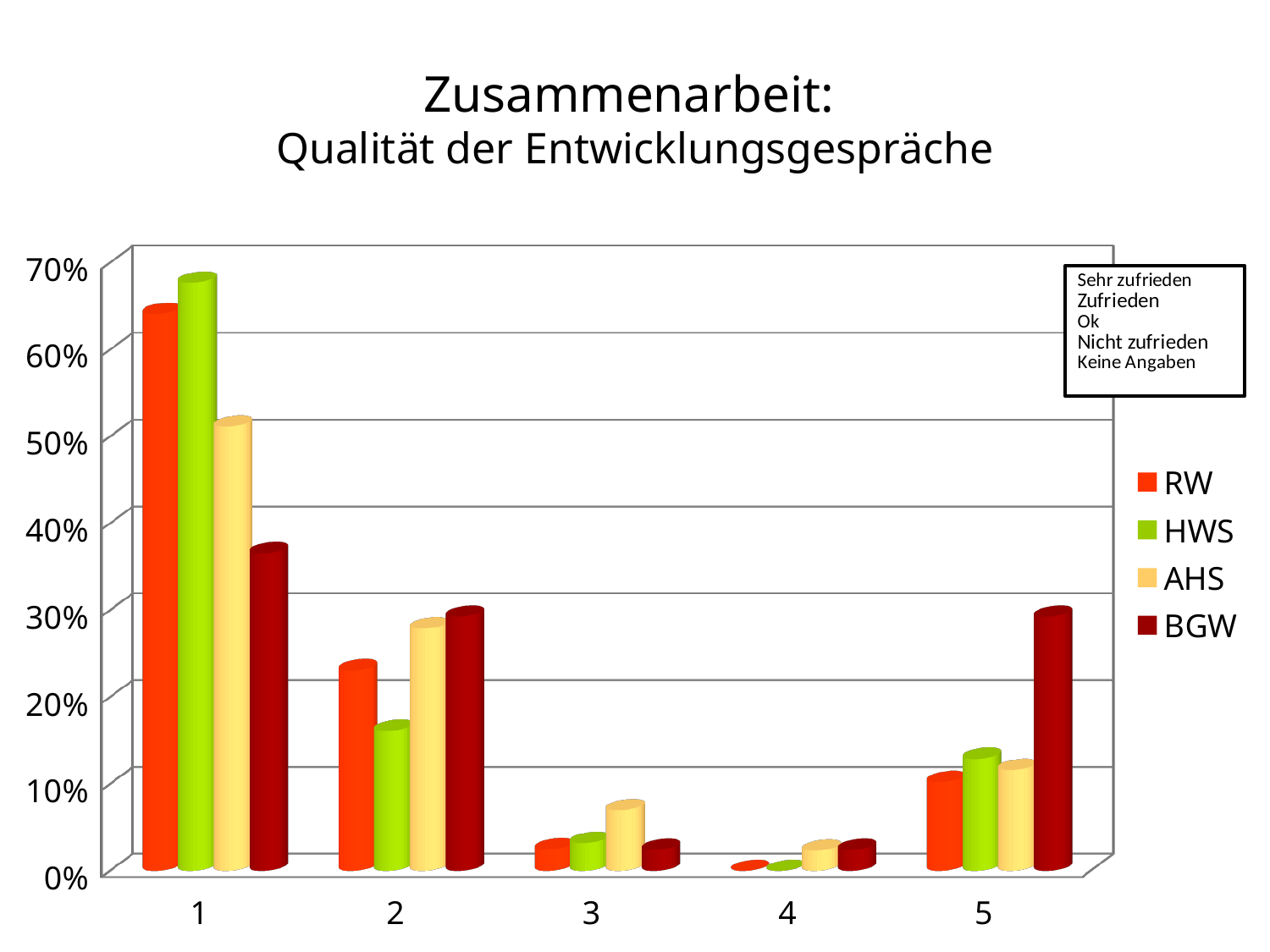
How many series does the legend list? 4 Is the value for RW in category 1 greater or less than 60%? greater Which series has the highest value in category 1? HWS In category 2, which is larger, the value for RW or the value for HWS? RW How many categories are shown on the x axis? 5 Which series has the highest value in category 5? BGW Which series has the lowest value in category 1? BGW Is the value for AHS in category 1 greater or less than 40%? greater What is the title of the chart? Zusammenarbeit: Qualität der Entwicklungsgespräche Is the value for BGW in category 1 greater or less than 30%? greater What kind of chart is shown on the slide? bar chart